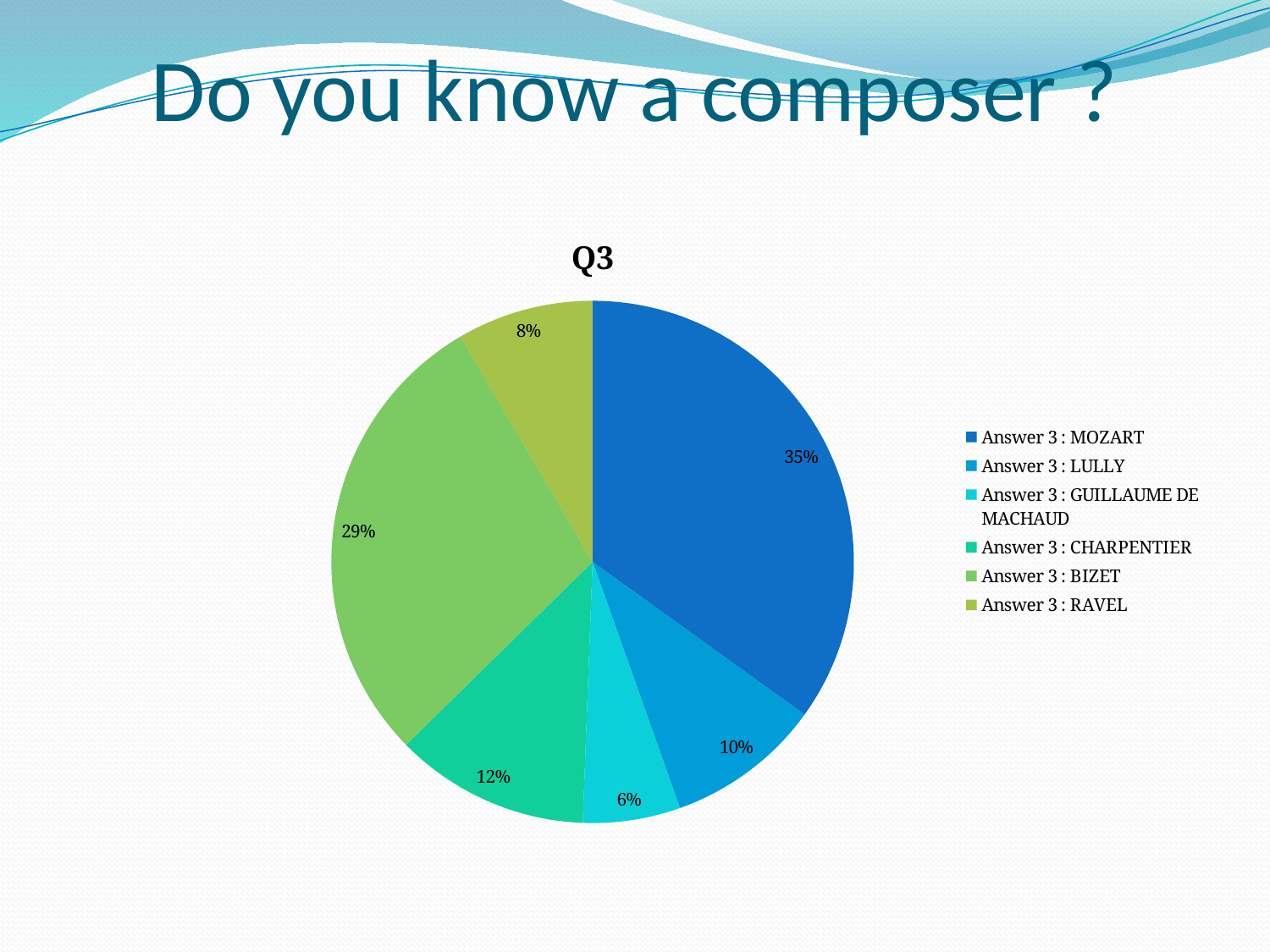
What share of the pie does MOZART have? 35% What share of the pie does RAVEL have? 8% What share of the pie does GUILLAUME DE MACHAUD have? 6% Which composer has the largest slice of the pie? MOZART Which composer has the smallest slice of the pie? GUILLAUME DE MACHAUD What is the title of the chart? Q3 What is the difference between the shares for MOZART and BIZET? 6% How many slices does the pie chart have? 6 What type of chart is shown on the slide? pie chart